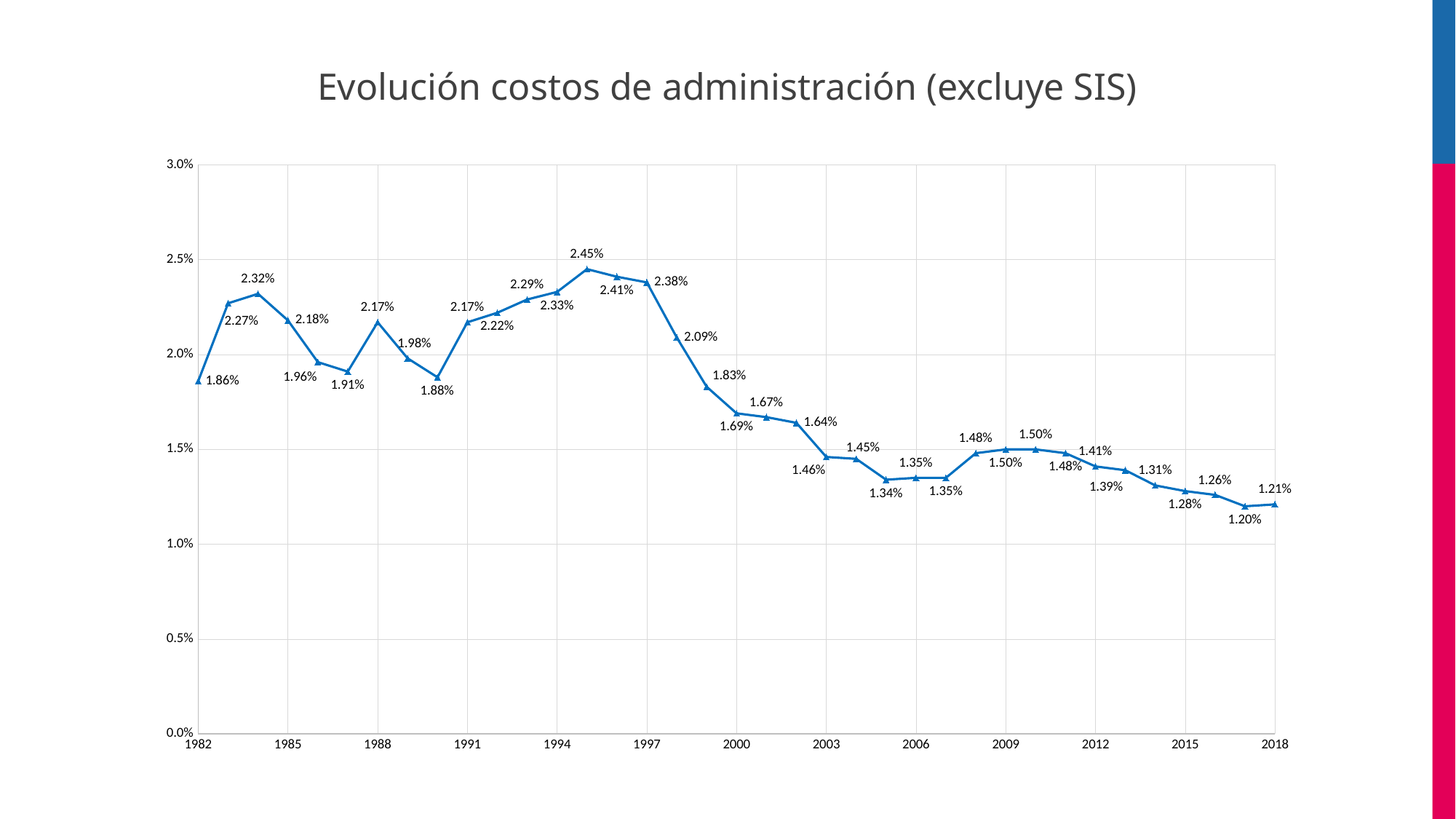
What is the value for 2018? 1.21% Which year has the larger value, 1985 or 2009? 1985 What kind of chart is shown on the slide? Line chart By how many percentage points did the value fall from 1982 to 2018? 0.65 percentage points In which year is the value highest, and what is it? 1995, 2.45% What is the value for 2000? 1.69% Is the value for 1997 greater or less than 2.0%? greater In which year is the value lowest, and what is it? 2017, 1.20% How many data points are plotted on the line? 37 What is the value for 1982? 1.86% Does the value generally rise or fall from 1997 to 2018? Fall What is the value for 1988? 2.17%